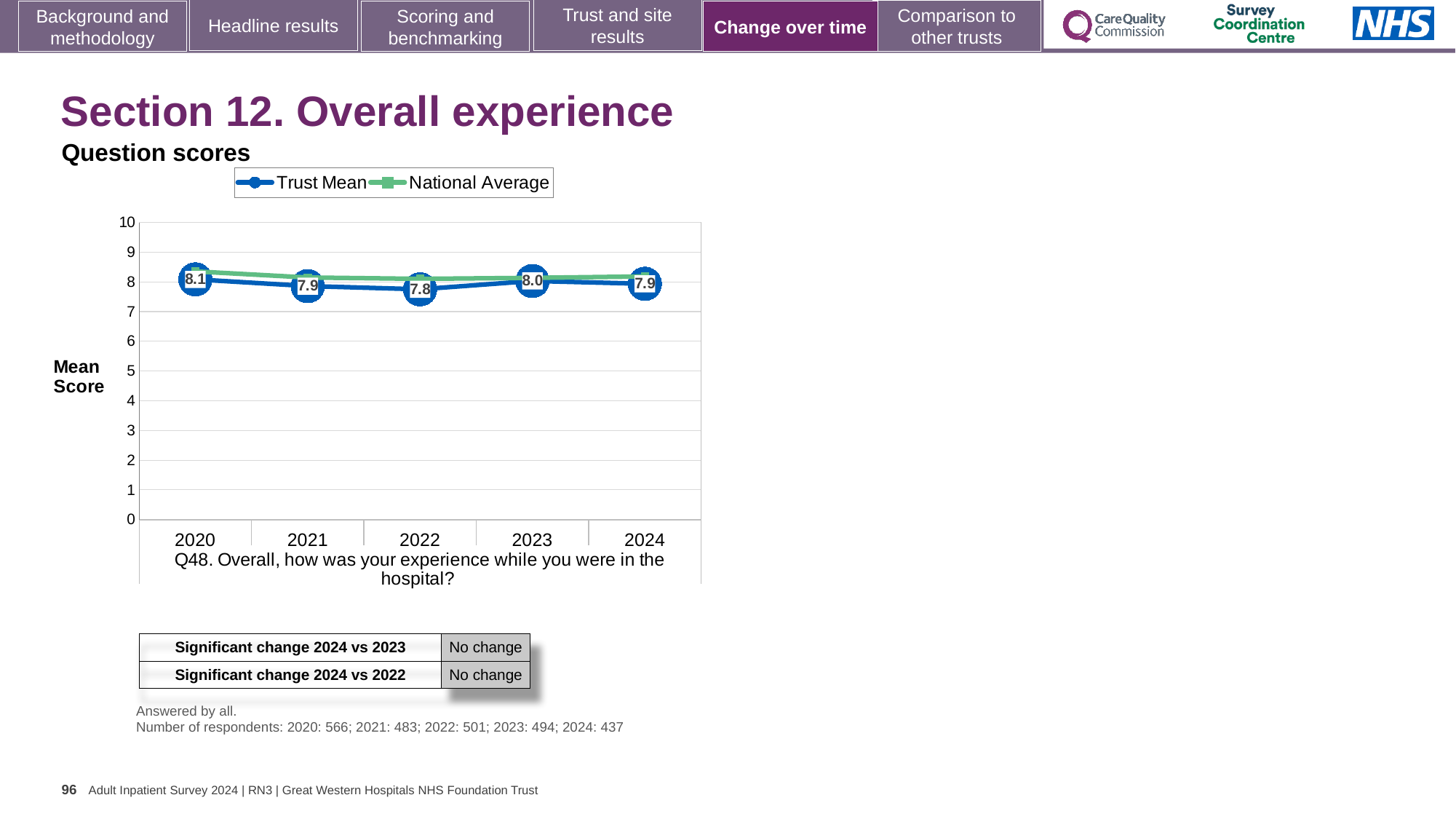
How many years are plotted on the x axis? 5 Is the National Average value for 2020 greater or less than 7? greater Which year has the larger Trust Mean score, 2023 or 2022? 2023 How many series does the legend list? 2 Does the Trust Mean score rise or fall from 2020 to 2022? Fall What is the Trust Mean score for 2020? 8.1 What is the difference between the Trust Mean score in 2020 and in 2022? 0.3 What kind of chart is shown? Line chart What is the Trust Mean score for 2022? 7.8 What is the Trust Mean score for 2024? 7.9 In which year is the Trust Mean score highest? 2020 In which year is the Trust Mean score lowest? 2022